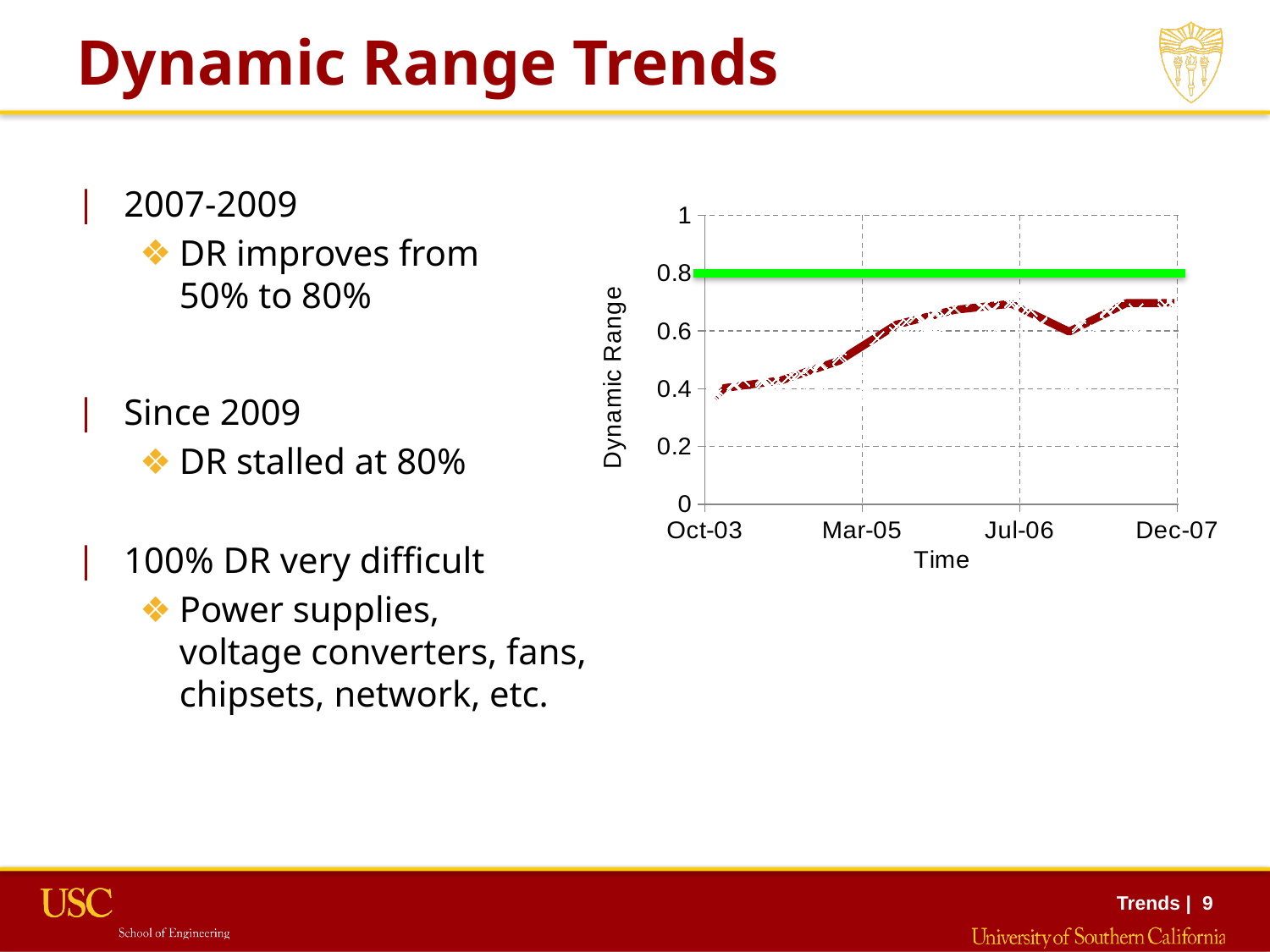
Which is larger at Dec-07: the dark red line or the green line? the green line Is the value of the dark red line at Oct-03 greater or less than 0.6? less Is the value of the dark red line at Jul-06 greater or less than 0.6? greater Does the dark red line generally rise or fall from Oct-03 to Jul-06? rise Is the value of the dark red line at Mar-05 greater or less than 0.4? greater What is the highest value shown on the y axis? 1 What kind of chart is shown on the slide? line chart What is the label of the y axis of the chart? Dynamic Range At what value on the y axis does the horizontal green line sit? 0.8 What is the label of the x axis of the chart? Time How many tick labels are shown on the x axis? 4